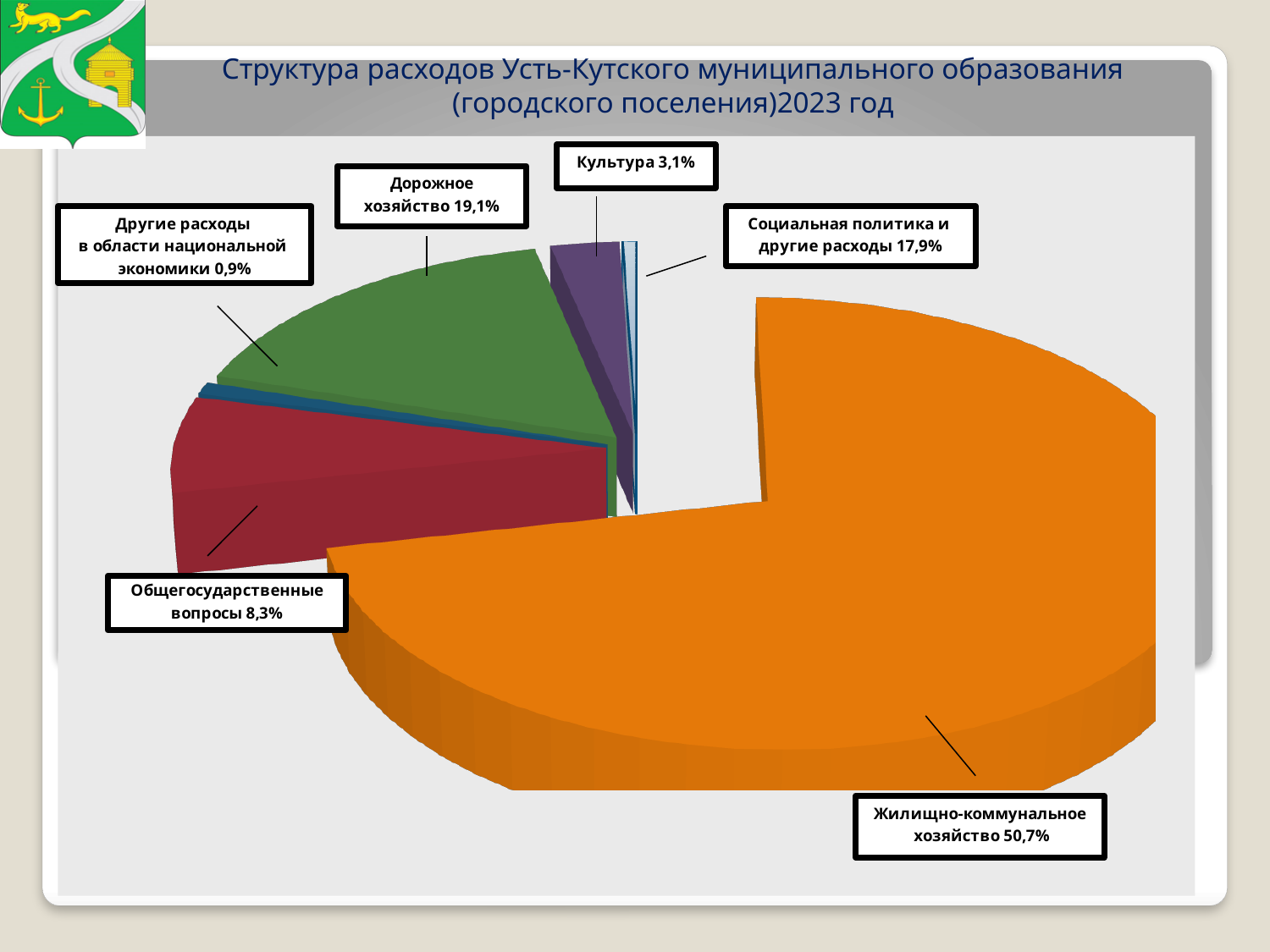
What kind of chart is shown on the slide? Pie chart Which is larger: the share for Дорожное хозяйство or for Социальная политика и другие расходы? Дорожное хозяйство Which category has the largest share of expenditures? Жилищно-коммунальное хозяйство What share is shown for Общегосударственные вопросы? 8,3% How many categories are labelled on the pie chart? 6 What year does the chart title refer to? 2023 What share of expenditures is labelled for Жилищно-коммунальное хозяйство? 50,7% What share is shown for Культура? 3,1% Which category has the smallest share of expenditures? Другие расходы в области национальной экономики What is the difference in percentage points between Жилищно-коммунальное хозяйство and Общегосударственные вопросы? 42,4 What share is shown for Дорожное хозяйство? 19,1% What share is shown for Социальная политика и другие расходы? 17,9%